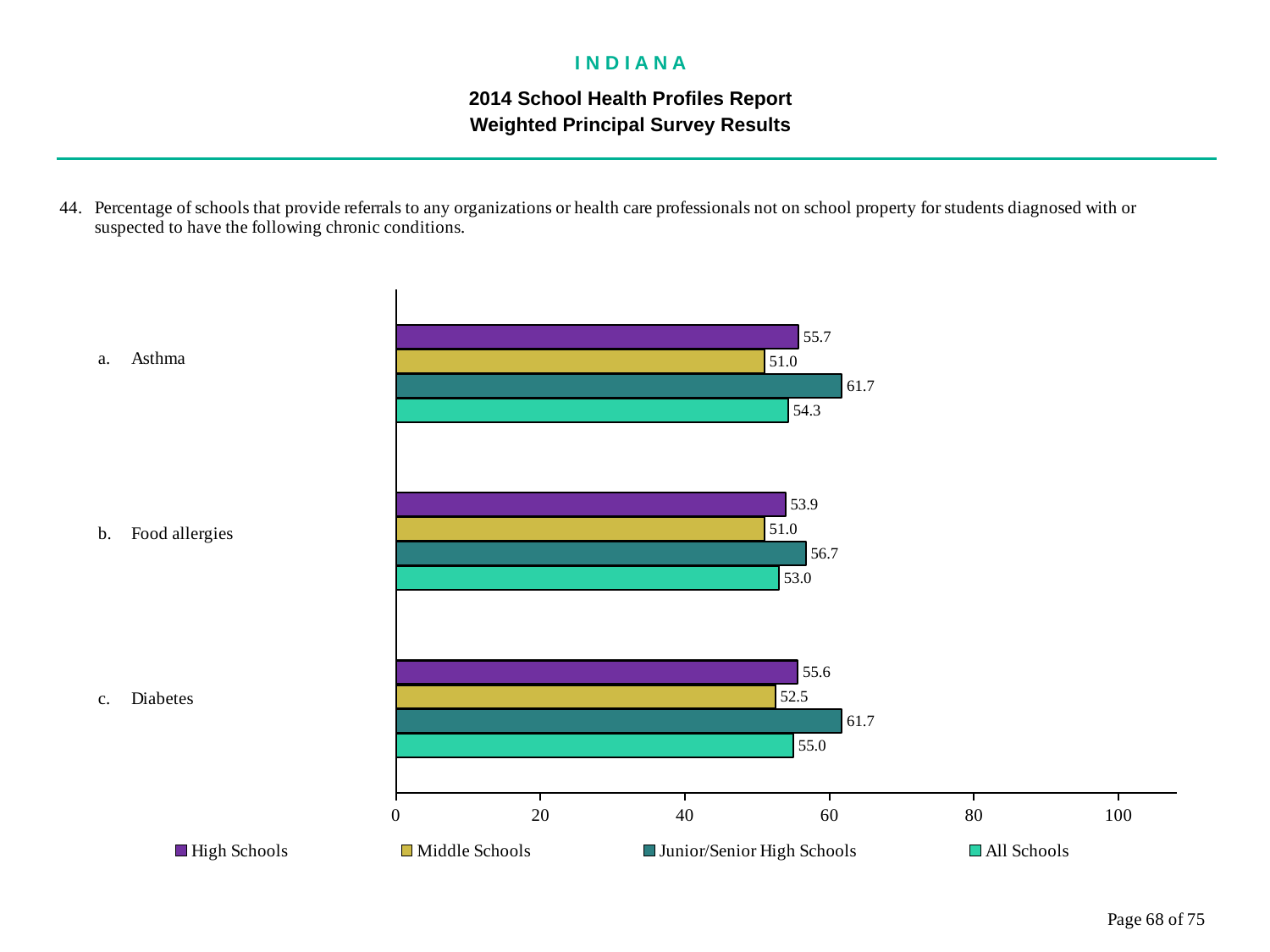
Which is larger for Food allergies: the High Schools value or the All Schools value? High Schools What kind of chart is shown on the slide? bar chart What is the value for All Schools for Food allergies? 53.0 How many chronic conditions are shown on the chart? 3 Which school type has the lowest value for Diabetes? Middle Schools What is the difference between the Junior/Senior High Schools and Middle Schools values for Asthma? 10.7 How many series does the legend list? 4 Is the value for Junior/Senior High Schools for Diabetes greater or less than 60? greater What is the value for Junior/Senior High Schools for Food allergies? 56.7 Which school type has the highest value for Asthma? Junior/Senior High Schools What is the value for Middle Schools for Diabetes? 52.5 What is the value for High Schools for Asthma? 55.7